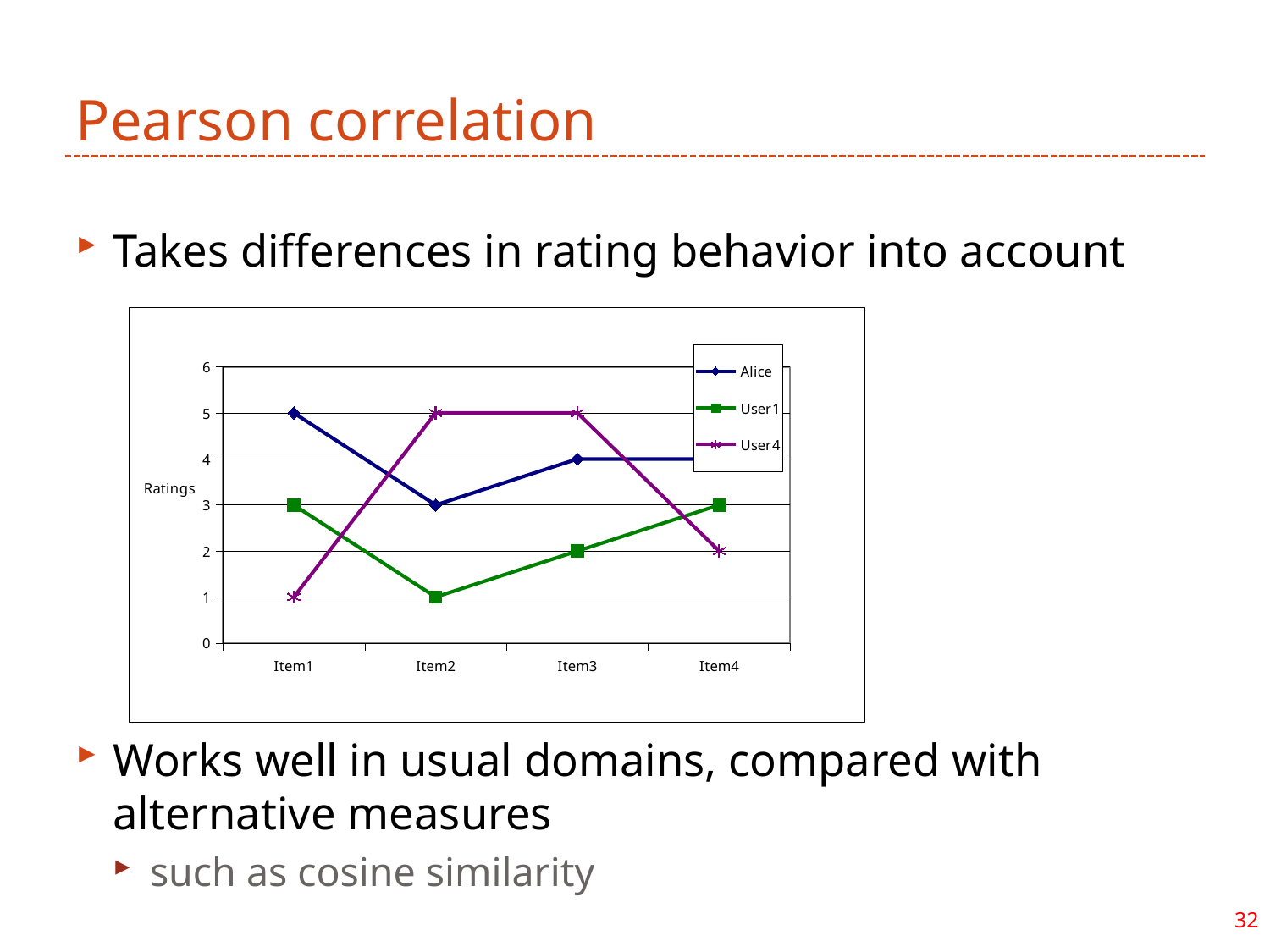
For which item is Alice's rating highest? Item1 What is the difference between Alice's and User1's ratings for Item2? 2 What kind of chart is shown on the slide? line chart What is User1's rating for Item2? 1 What is Alice's rating for Item1? 5 Which is larger for Item4: Alice's rating or User4's rating? Alice For which item is User4's rating lowest? Item1 How many series does the legend list? 3 How many items are shown on the x axis? 4 What is the label on the y axis? Ratings Does User1's rating rise or fall from Item2 to Item4? rise What is User4's rating for Item3? 5